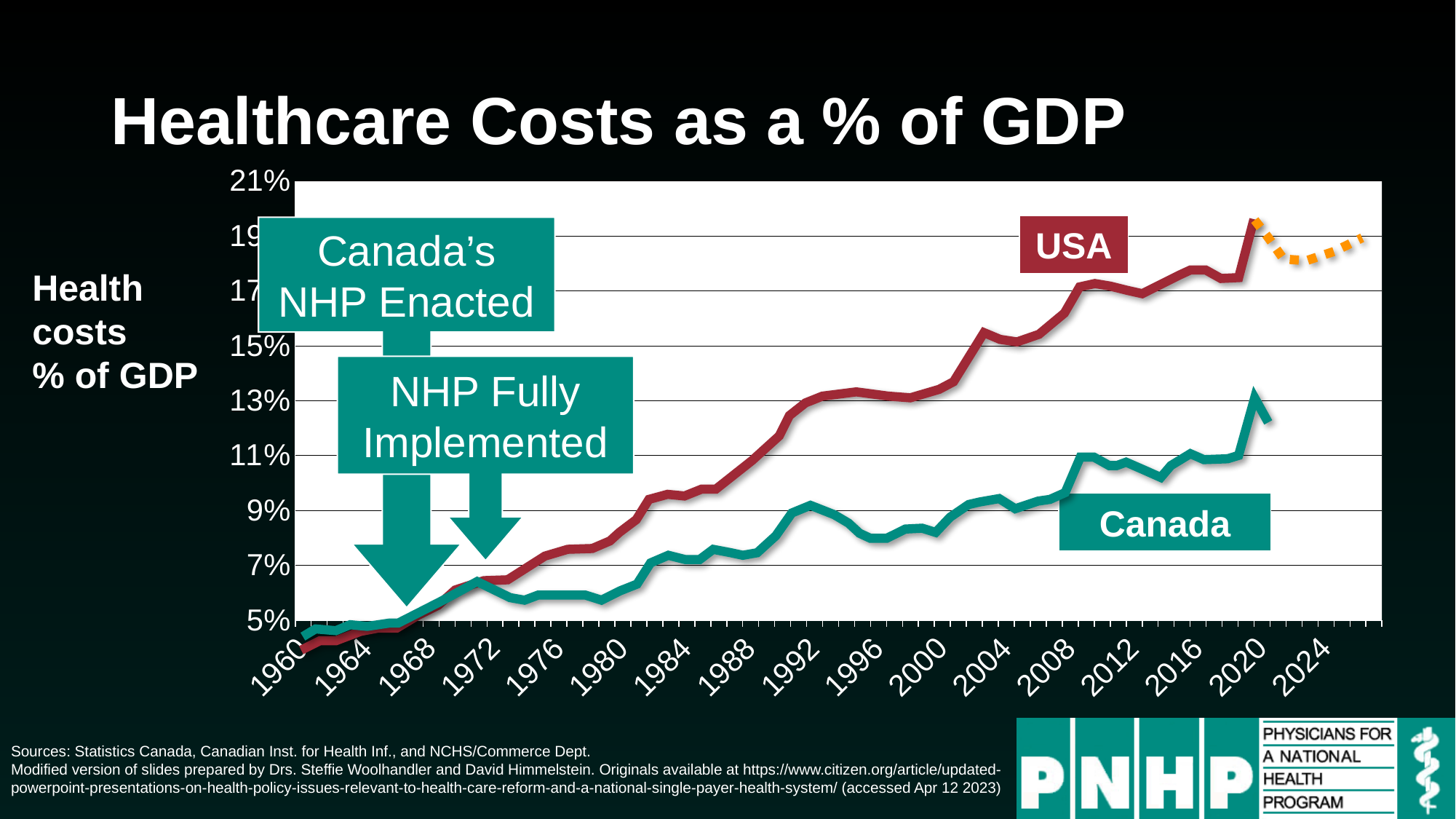
Is the value for Canada in 2008 greater or less than 11%? less What is the highest value shown on the vertical axis? 21% Which series is higher in 2004, USA or Canada? USA Which series has the higher value in 2020, USA or Canada? USA Is the value for the USA in 2000 greater or less than 11%? greater What kind of chart is shown on the slide? Line chart What is the title of the chart? Healthcare Costs as a % of GDP Is the value for the USA in 2020 greater or less than 17%? greater How many series are plotted on the chart? 2 Does the USA line generally rise or fall from 1960 to 2020? Rise